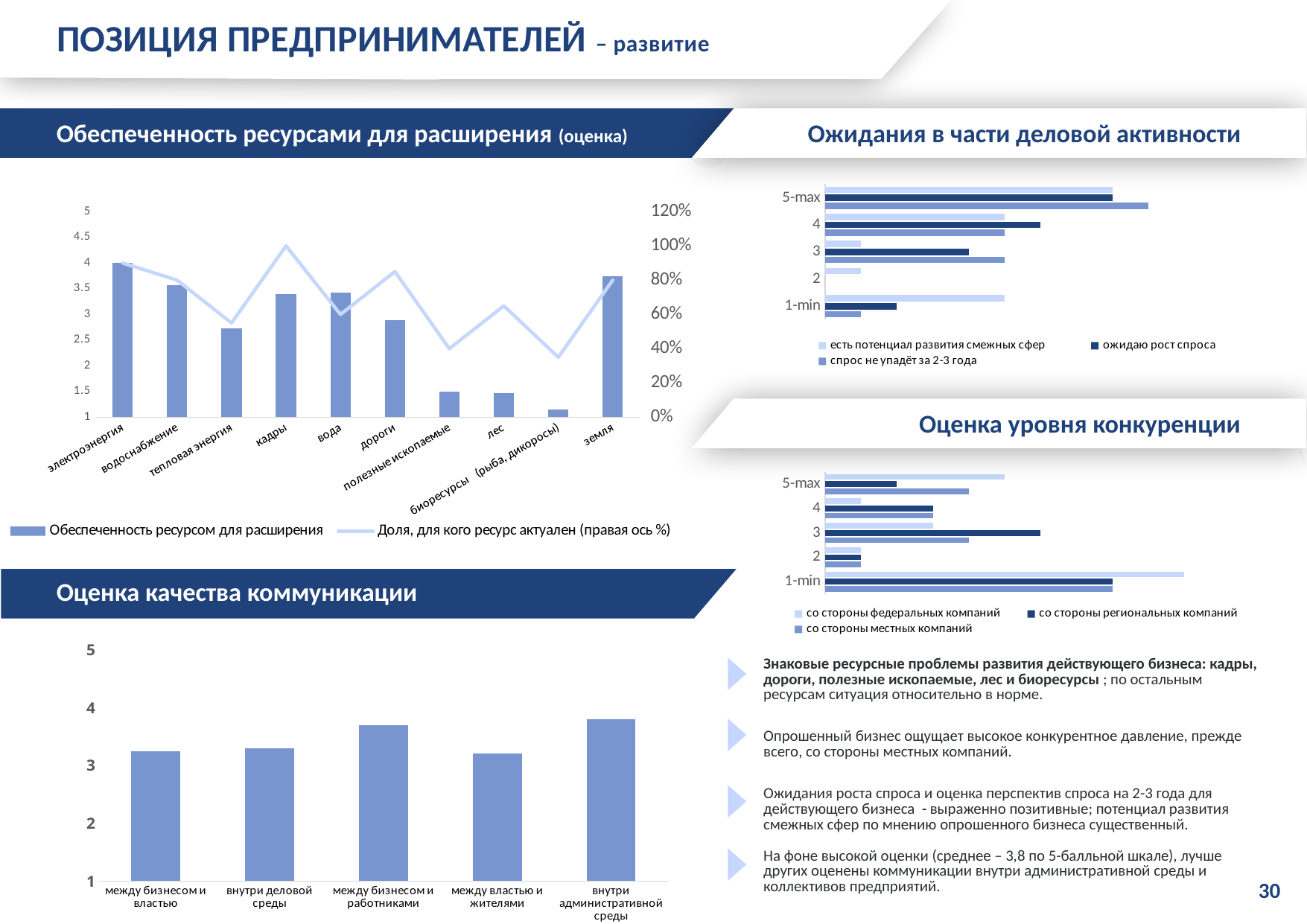
In the chart 'Обеспеченность ресурсами для расширения', how many resource categories are shown on the x axis? 10 In the chart 'Оценка качества коммуникации', is the bar for 'между бизнесом и властью' greater or less than 3? greater In the chart 'Оценка уровня конкуренции', how many rating categories are shown on the vertical axis? 5 In the chart 'Оценка уровня конкуренции', what is the legend entry shown in the darkest blue? со стороны региональных компаний In the chart 'Оценка качества коммуникации', is the bar for 'внутри административной среды' greater or less than 4? less In the chart 'Обеспеченность ресурсами для расширения', which category has the lowest bar? биоресурсы (рыба, дикоросы) In the chart 'Обеспеченность ресурсами для расширения', how many series does the legend list? 2 In the chart 'Ожидания в части деловой активности', how many series does the legend list? 3 What kind of chart is 'Ожидания в части деловой активности'? bar chart In the chart 'Обеспеченность ресурсами для расширения', is the bar for кадры greater or less than 3? greater In the chart 'Обеспеченность ресурсами для расширения', which is larger: the bar for электроэнергия or the bar for тепловая энергия? электроэнергия